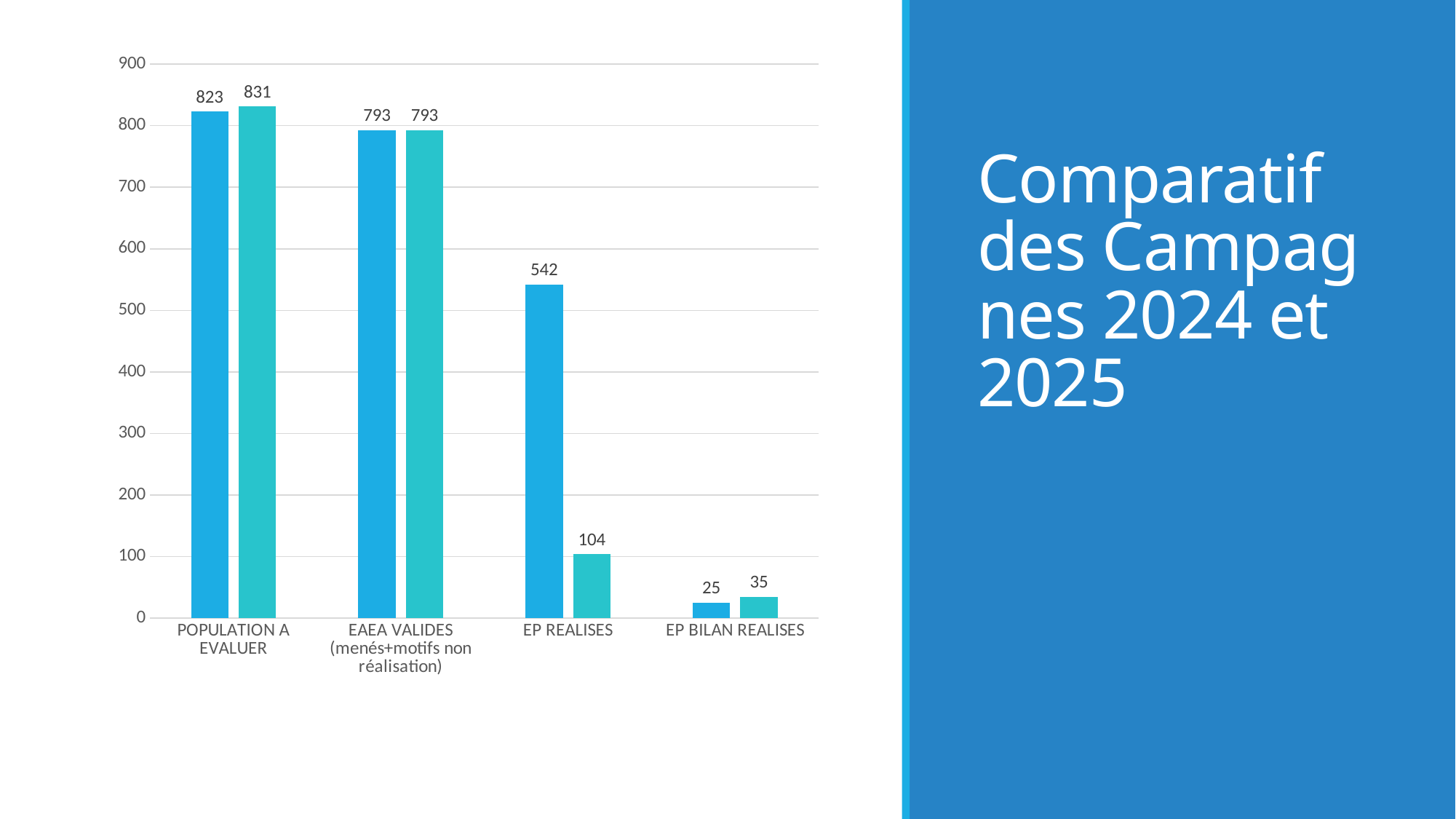
What is the value of the teal (right) bar for EP BILAN REALISES? 35 Which category has the lowest teal (right) bar? EP BILAN REALISES What is the value of the blue (left) bar for POPULATION A EVALUER? 823 For EP BILAN REALISES, which bar is larger, the blue (left) one or the teal (right) one? the teal (right) bar What is the difference between the teal bar and the blue bar for POPULATION A EVALUER? 8 How many categories are shown on the x axis of the chart? 4 What is the difference between the blue bar and the teal bar for EP REALISES? 438 Which category has the highest blue (left) bar? POPULATION A EVALUER What is the value of the teal (right) bar for EP REALISES? 104 What kind of chart is shown on the slide? bar chart Do the blue (left) bars rise or fall from left to right across the categories? fall What value do both bars show for EAEA VALIDES (menés+motifs non réalisation)? 793